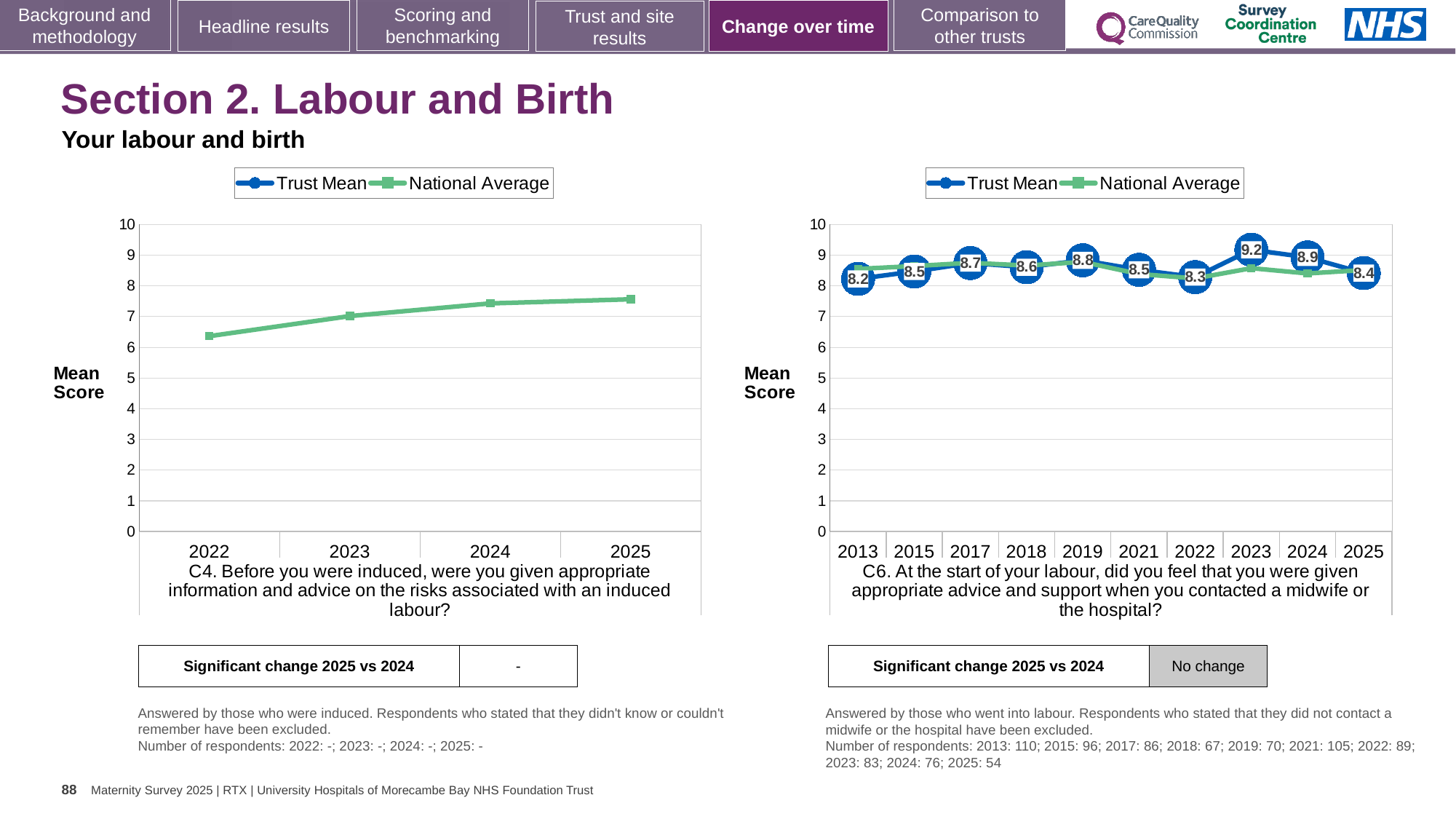
On the left chart (C4), is the National Average value for 2022 greater or less than 6? greater On the right chart (C6), is the Trust Mean score higher in 2023 or in 2024? 2023 On the left chart (C4), does the National Average line rise or fall from 2022 to 2025? rise How many series does the legend of the left chart (C4) list? 2 On the right chart (C6), which year has the highest Trust Mean score? 2023 On the left chart (C4), how many years are shown on the x axis? 4 On the right chart (C6), what is the difference between the Trust Mean scores for 2023 and 2013? 1.0 On the right chart (C6), which year has the lowest Trust Mean score? 2013 On the right chart (C6), how many years are shown on the x axis? 10 On the right chart (C6), what is the Trust Mean score for 2025? 8.4 On the right chart (C6), what is the Trust Mean score for 2013? 8.2 On the right chart (C6), what is the Trust Mean score for 2023? 9.2